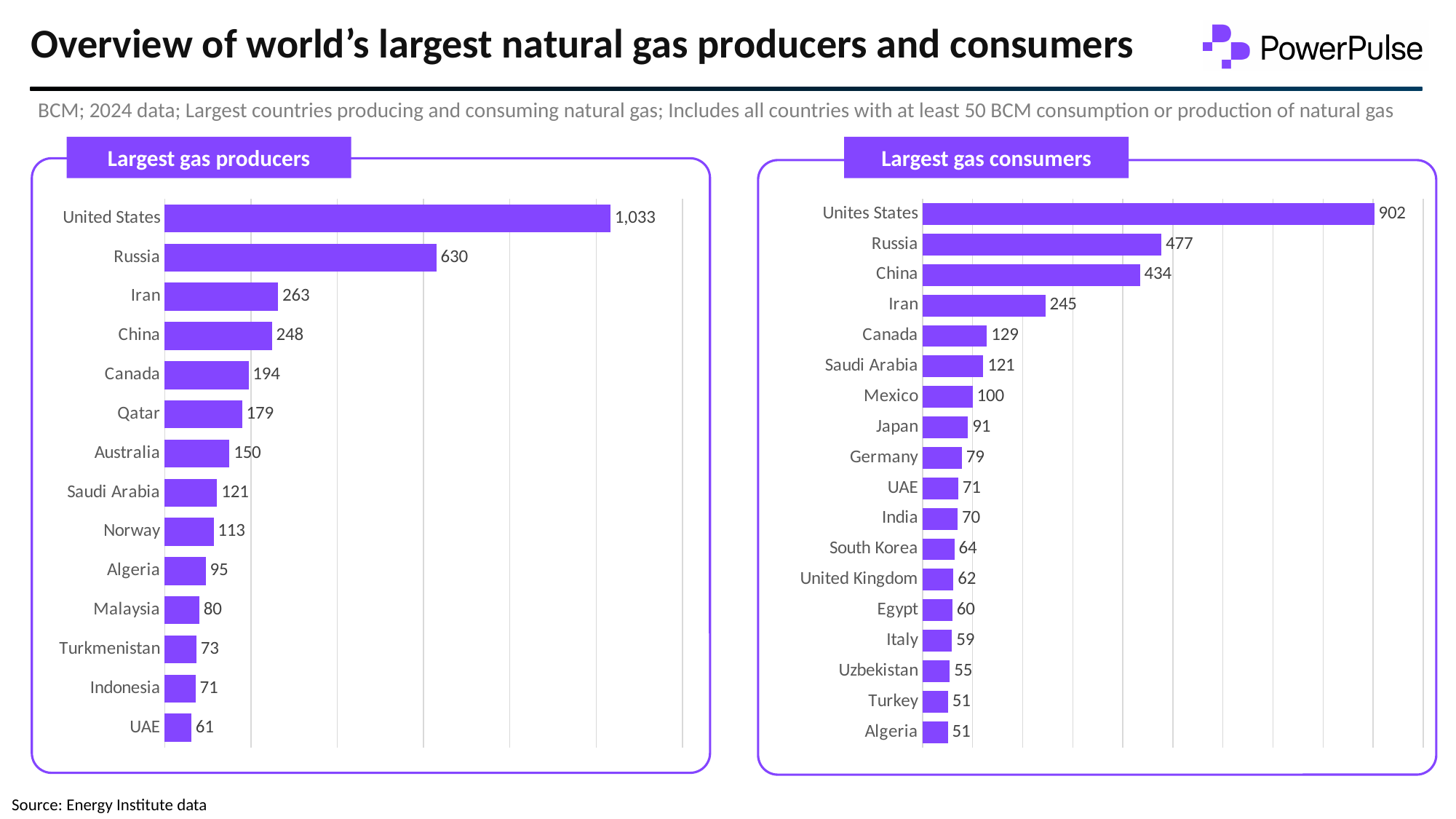
In the 'Largest gas producers' chart, which country has the highest value? United States In the 'Largest gas producers' chart, what is the difference between the values for United States and Russia? 403 In the 'Largest gas producers' chart, which is larger, the value for Iran or the value for China? Iran In the 'Largest gas consumers' chart, which country has the lowest value? Turkey and Algeria (both 51) How many countries are shown in the 'Largest gas consumers' chart? 18 In the 'Largest gas consumers' chart, what is the value for China? 434 How many countries are shown in the 'Largest gas producers' chart? 14 In the 'Largest gas consumers' chart, which is larger, the value for Canada or the value for Mexico? Canada In the 'Largest gas producers' chart, what is the value for Russia? 630 In the 'Largest gas consumers' chart, what is the difference between the values for Russia and Iran? 232 What kind of chart is the 'Largest gas consumers' chart? Bar chart In the 'Largest gas producers' chart, what is the value for Qatar? 179